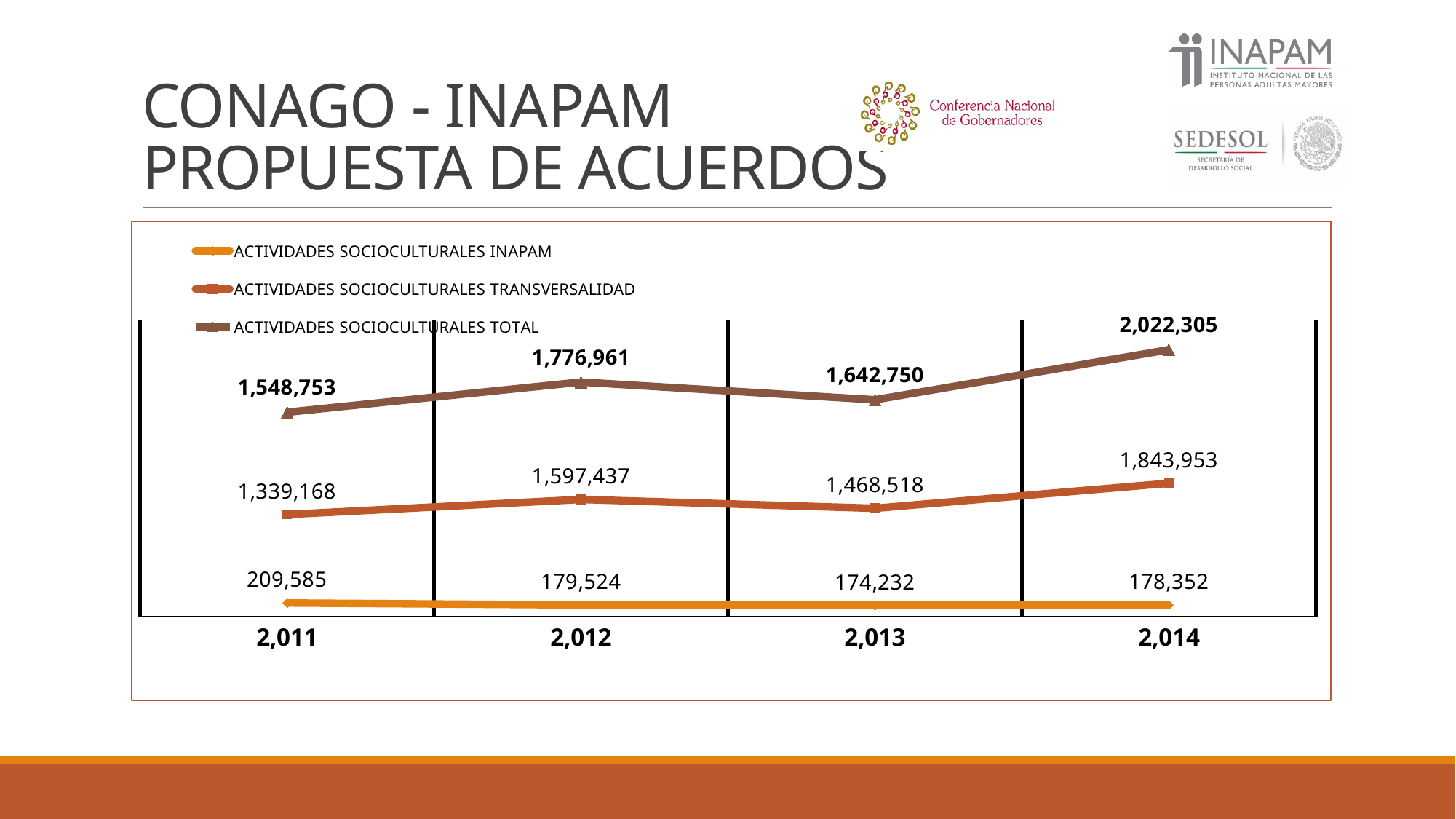
How many years are shown on the x axis? 4 What is the difference between ACTIVIDADES SOCIOCULTURALES TOTAL in 2,014 and in 2,013? 379,555 What is the value of ACTIVIDADES SOCIOCULTURALES TOTAL in 2,014? 2,022,305 Does ACTIVIDADES SOCIOCULTURALES TRANSVERSALIDAD rise or fall from 2,013 to 2,014? rise What is the value of ACTIVIDADES SOCIOCULTURALES INAPAM in 2,013? 174,232 What kind of chart is shown on the slide? line chart Which is larger: ACTIVIDADES SOCIOCULTURALES TRANSVERSALIDAD in 2,012 or in 2,013? 2,012 What is the difference between ACTIVIDADES SOCIOCULTURALES INAPAM in 2,011 and in 2,012? 30,061 What is the value of ACTIVIDADES SOCIOCULTURALES TRANSVERSALIDAD in 2,012? 1,597,437 How many series does the legend list? 3 In which year is ACTIVIDADES SOCIOCULTURALES TOTAL lowest? 2,011 In which year is ACTIVIDADES SOCIOCULTURALES INAPAM highest? 2,011